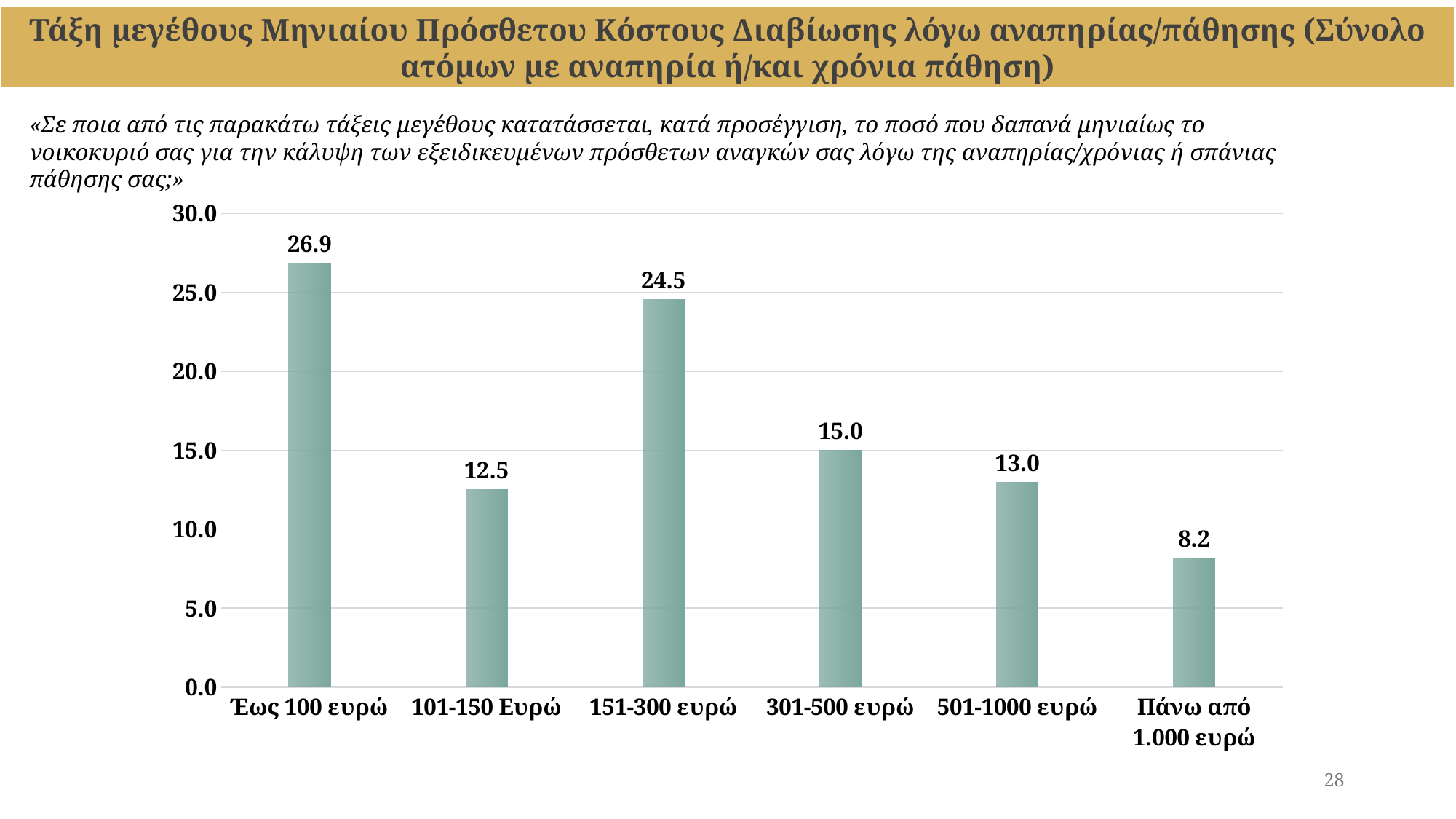
What is the value for the '151-300 ευρώ' category? 24.5 What is the value for the 'Έως 100 ευρώ' category? 26.9 What is the value for the '501-1000 ευρώ' category? 13.0 What is the difference between the values for 'Έως 100 ευρώ' and '151-300 ευρώ'? 2.4 Which category has the lowest value? Πάνω από 1.000 ευρώ Is the value for '101-150 Ευρώ' greater or less than 15.0? less How many categories are shown on the x axis? 6 What is the highest value shown on the y axis? 30.0 Which is larger, the value for '301-500 ευρώ' or the value for '101-150 Ευρώ'? 301-500 ευρώ What kind of chart is shown on the slide? bar chart What is the value for the 'Πάνω από 1.000 ευρώ' category? 8.2 Which category has the highest value? Έως 100 ευρώ